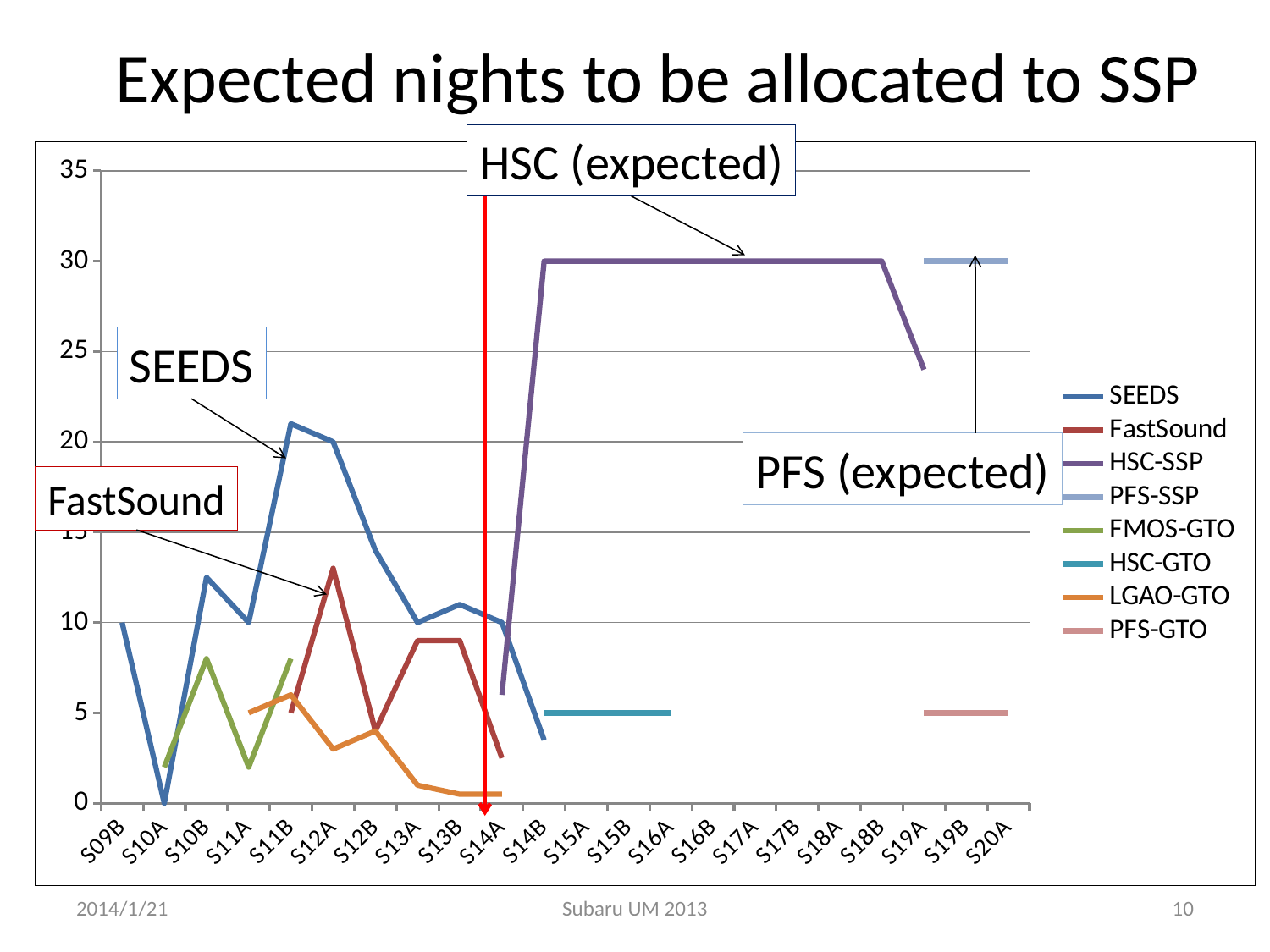
How many series does the legend list? 8 How many semester categories are shown along the x axis? 22 What is the value of HSC-SSP at S15A? 30 Is the value for FastSound at S12A greater or less than 10? greater Is the value for HSC-SSP at S19A greater or less than 25? less What kind of chart is shown on the slide? line chart What is the title of the slide? Expected nights to be allocated to SSP What is the value of PFS-GTO at S20A? 5 At S15A, which is larger, HSC-SSP or HSC-GTO? HSC-SSP What is the value of PFS-SSP at S20A? 30 What is the value of SEEDS at S10A? 0 What is the value of HSC-GTO at S15A? 5